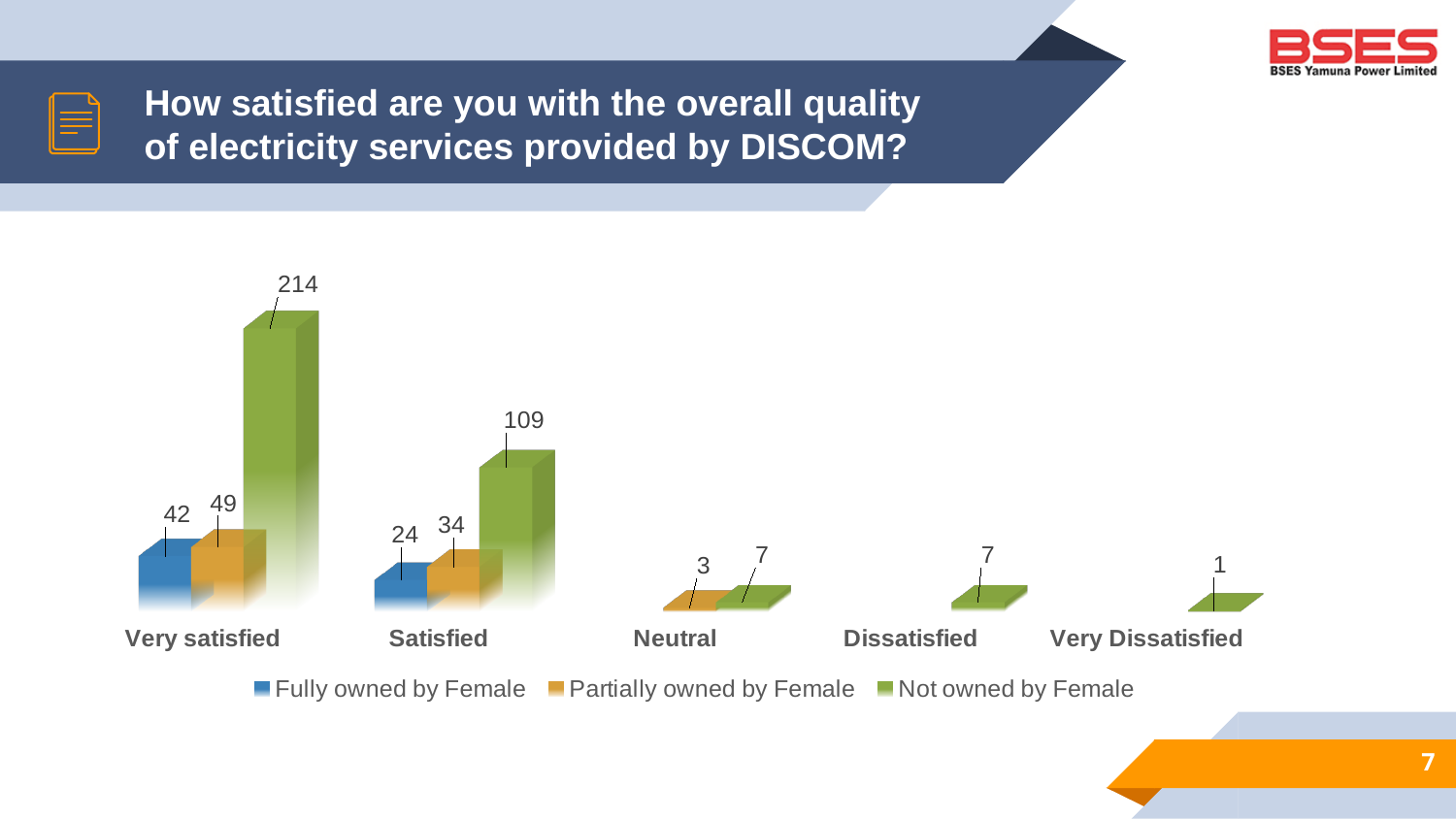
Which colour represents the Not owned by Female series? Green Which is larger in the Satisfied category: Fully owned by Female or Partially owned by Female? Partially owned by Female How many series does the legend list? 3 What is the value for Not owned by Female in the Very satisfied category? 214 Which category has the lowest value for Not owned by Female? Very Dissatisfied What is the value for Not owned by Female in the Very Dissatisfied category? 1 What kind of chart is shown on the slide? Bar chart What is the difference between the Not owned by Female values for Very satisfied and Satisfied? 105 How many categories are shown on the x axis? 5 What is the value for Partially owned by Female in the Very satisfied category? 49 What is the value for Fully owned by Female in the Satisfied category? 24 Which category has the highest value for Not owned by Female? Very satisfied